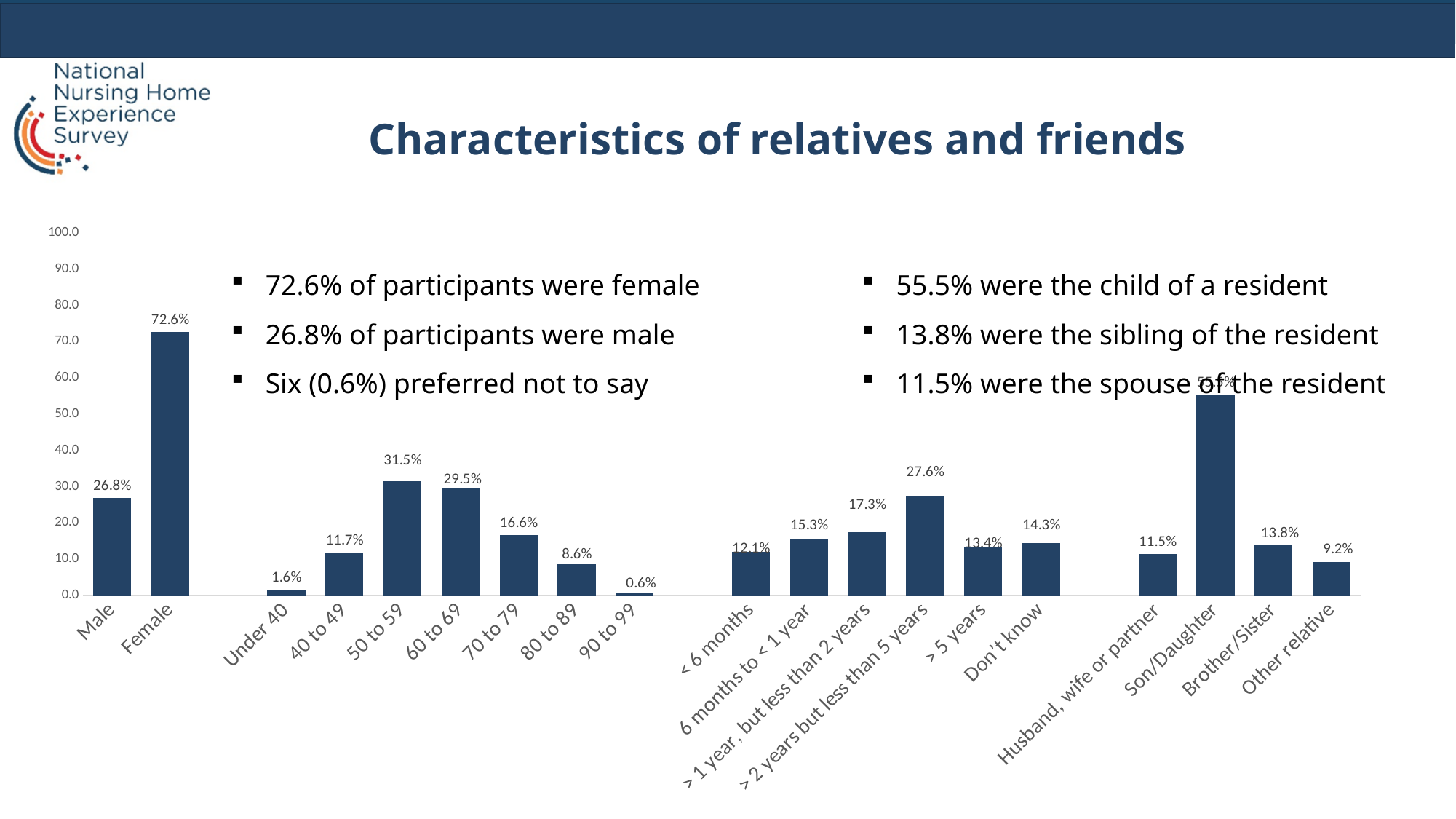
What is the value for Female? 72.6% Which age group has the lowest value? 90 to 99 What is the value for Brother/Sister? 13.8% Which age group has the highest value? 50 to 59 What is the value for the 50 to 59 age group? 31.5% What is the value for '> 2 years but less than 5 years'? 27.6% Which is larger, the value for '> 5 years' or the value for 'Don't know'? Don't know What is the title of the slide containing the chart? Characteristics of relatives and friends What is the difference between the values for Female and Male? 45.8% Is the value for Son/Daughter greater or less than 50.0? greater What kind of chart is shown on the slide? Bar chart How many categories are shown on the x axis of the chart? 19